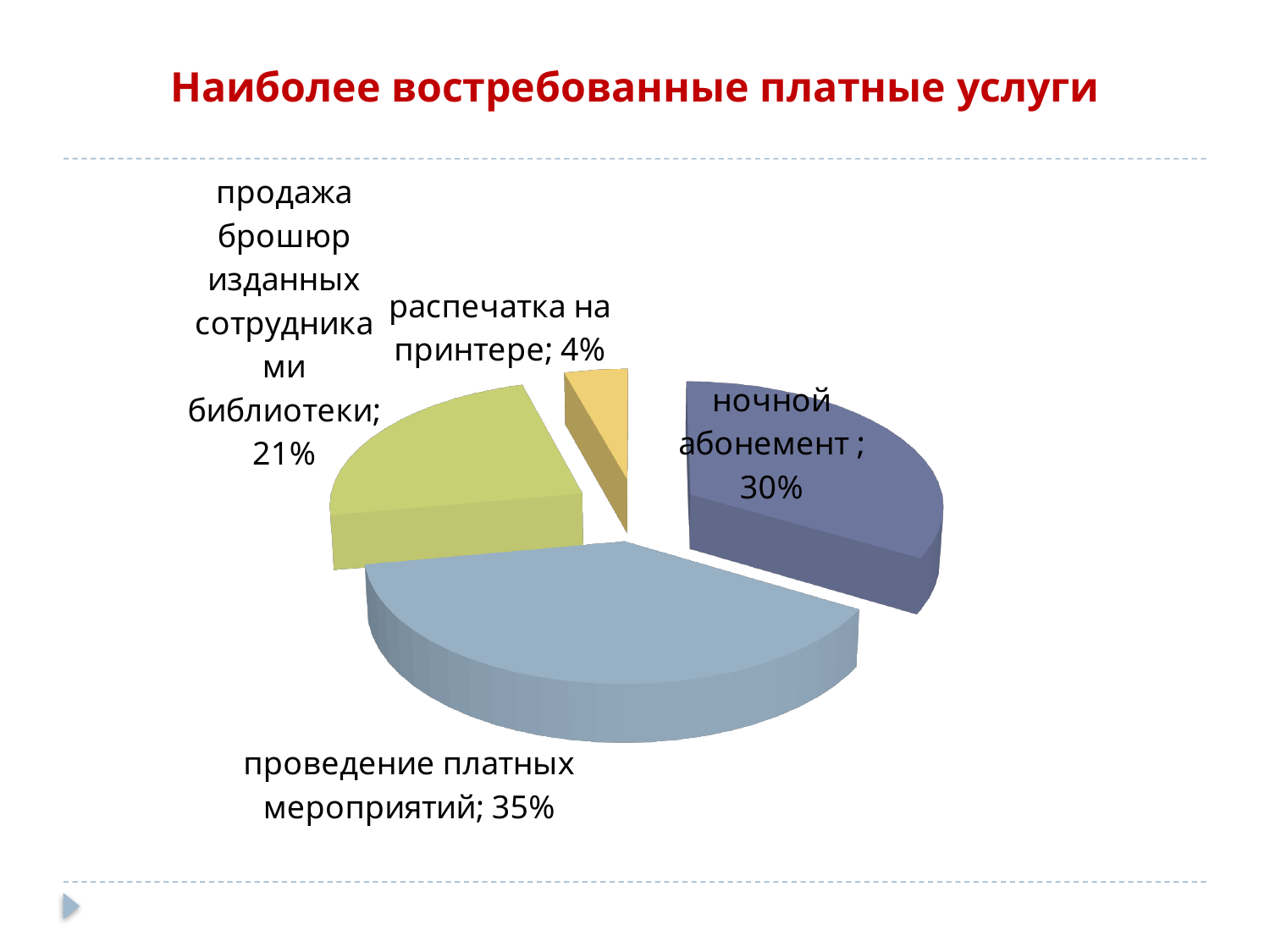
What share of the pie does 'проведение платных мероприятий' have? 35% Which category has the smallest slice of the pie? распечатка на принтере What share of the pie does 'распечатка на принтере' have? 4% How many slices does the pie chart have? 4 What is the title of the slide? Наиболее востребованные платные услуги What share of the pie does 'ночной абонемент' have? 30% Which category has the largest slice of the pie? проведение платных мероприятий Which is larger: the slice for 'ночной абонемент' or the slice for 'продажа брошюр изданных сотрудниками библиотеки'? ночной абонемент What is the difference in percentage points between 'проведение платных мероприятий' and 'ночной абонемент'? 5 What is the difference in percentage points between 'продажа брошюр изданных сотрудниками библиотеки' and 'распечатка на принтере'? 17 What share of the pie does 'продажа брошюр изданных сотрудниками библиотеки' have? 21% What kind of chart is shown on the slide? pie chart